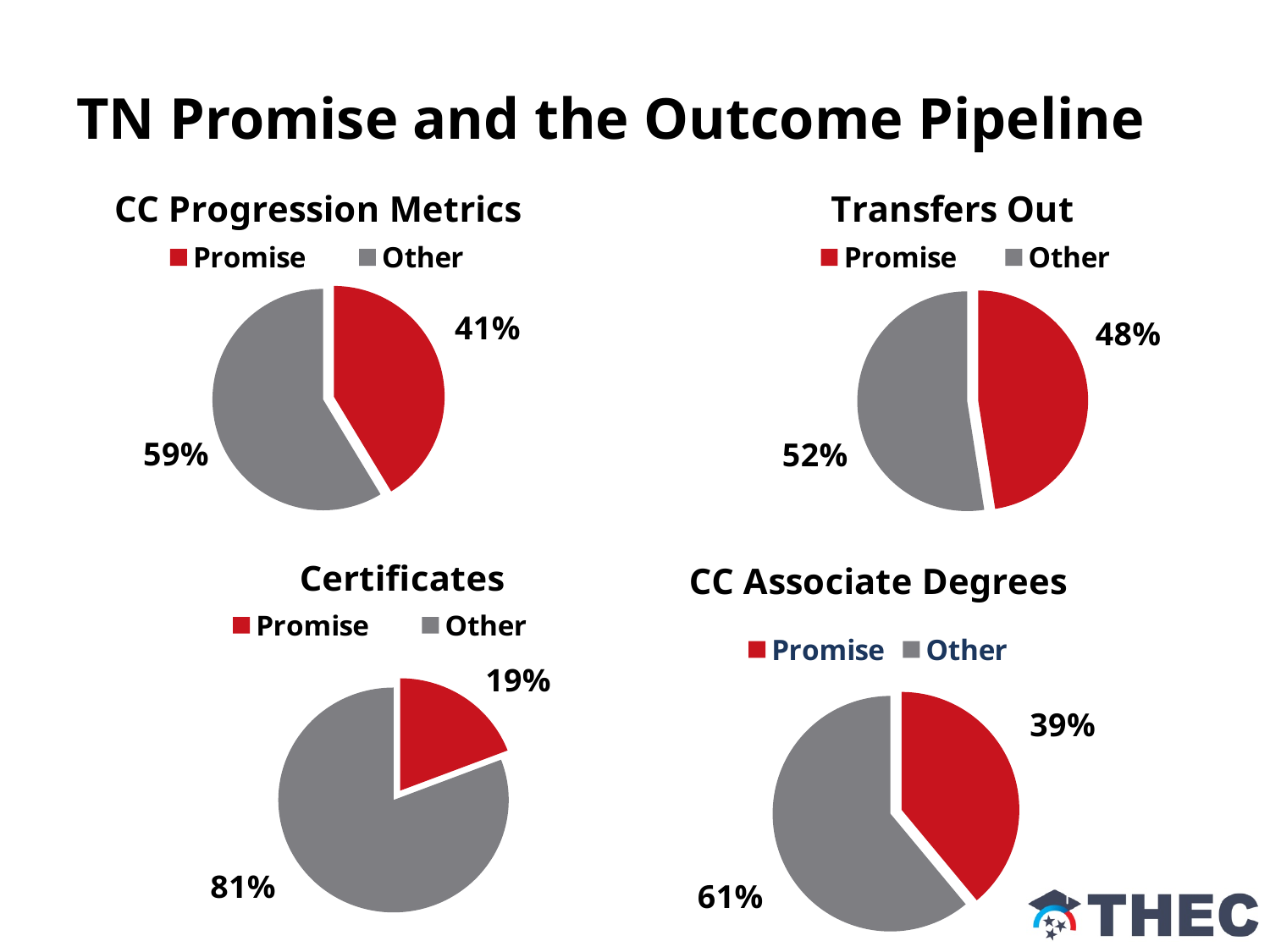
What kind of chart is the 'Transfers Out' chart? Pie chart In the 'Transfers Out' chart, what share of the pie is Other? 52% In the 'CC Progression Metrics' chart, what is the value for Other? 59% In the 'CC Associate Degrees' chart, what share of the pie is Promise? 39% How many entries does the legend of the 'Certificates' chart list? 2 In the 'CC Progression Metrics' chart, which slice is larger, Promise or Other? Other In the 'Certificates' chart, what is the value for Other? 81% In the 'Certificates' chart, what is the difference between Other and Promise? 62% In the 'Certificates' chart, what is the value for Promise? 19% In the 'CC Progression Metrics' chart, what share of the pie is Promise? 41% In the 'Transfers Out' chart, what is the value for Promise? 48% In the 'CC Associate Degrees' chart, what is the value for Other? 61%